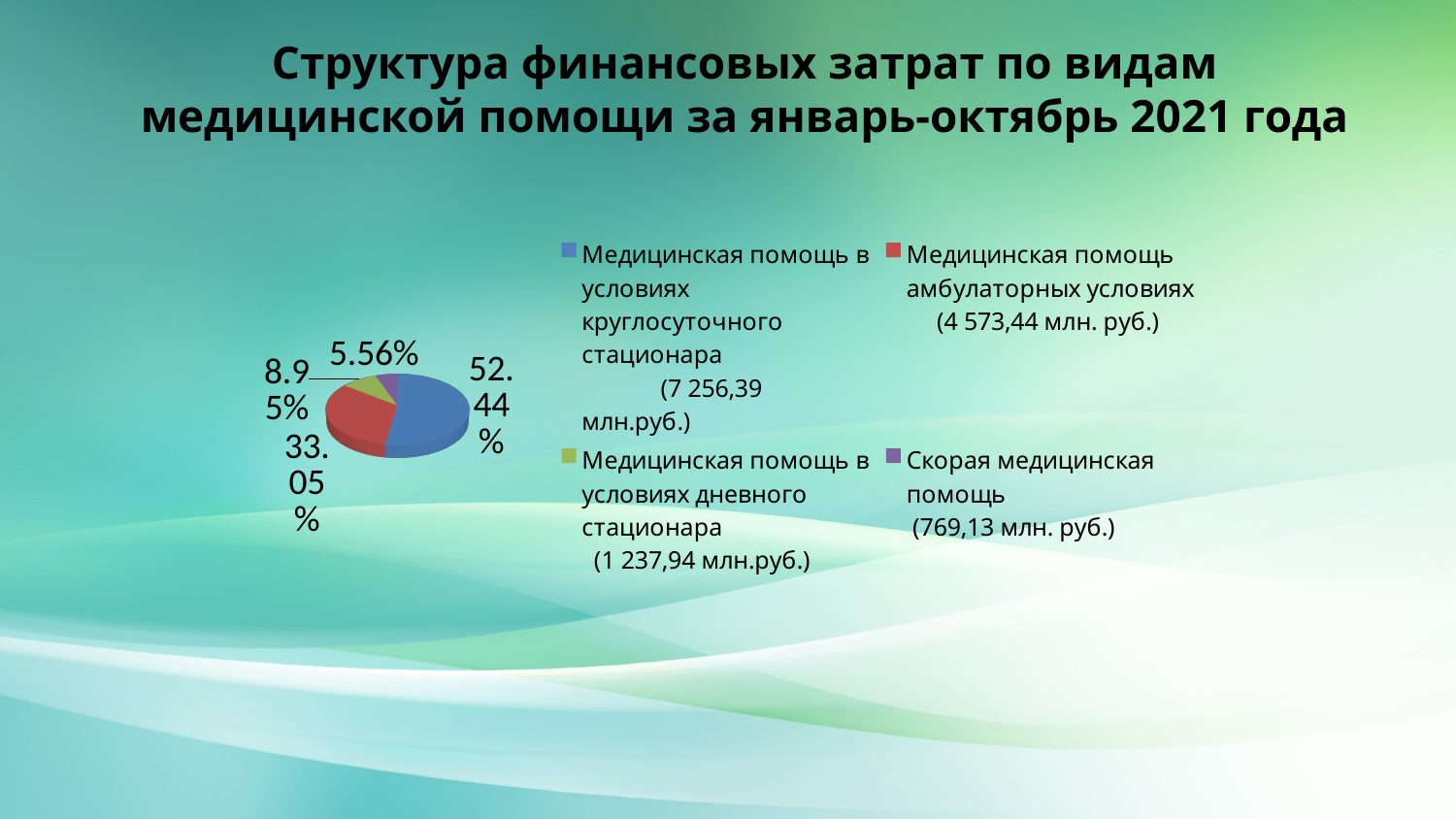
What share of the pie is labelled for Медицинская помощь в условиях круглосуточного стационара? 52.44% What amount in млн. руб. does the legend give for Скорая медицинская помощь? 769,13 млн. руб. Which category has the smallest slice of the pie? Скорая медицинская помощь What kind of chart is shown on the slide? pie chart What share of the pie is labelled for Медицинская помощь в амбулаторных условиях? 33.05% How many entries does the legend list? 4 How many slices does the pie chart have? 4 Which is larger: the share for Медицинская помощь в амбулаторных условиях or the share for Медицинская помощь в условиях дневного стационара? Медицинская помощь в амбулаторных условиях What share of the pie is labelled for Скорая медицинская помощь? 5.56% Which category has the largest slice of the pie? Медицинская помощь в условиях круглосуточного стационара What is the difference in percentage points between the largest slice (52.44%) and the second largest slice (33.05%)? 19.39